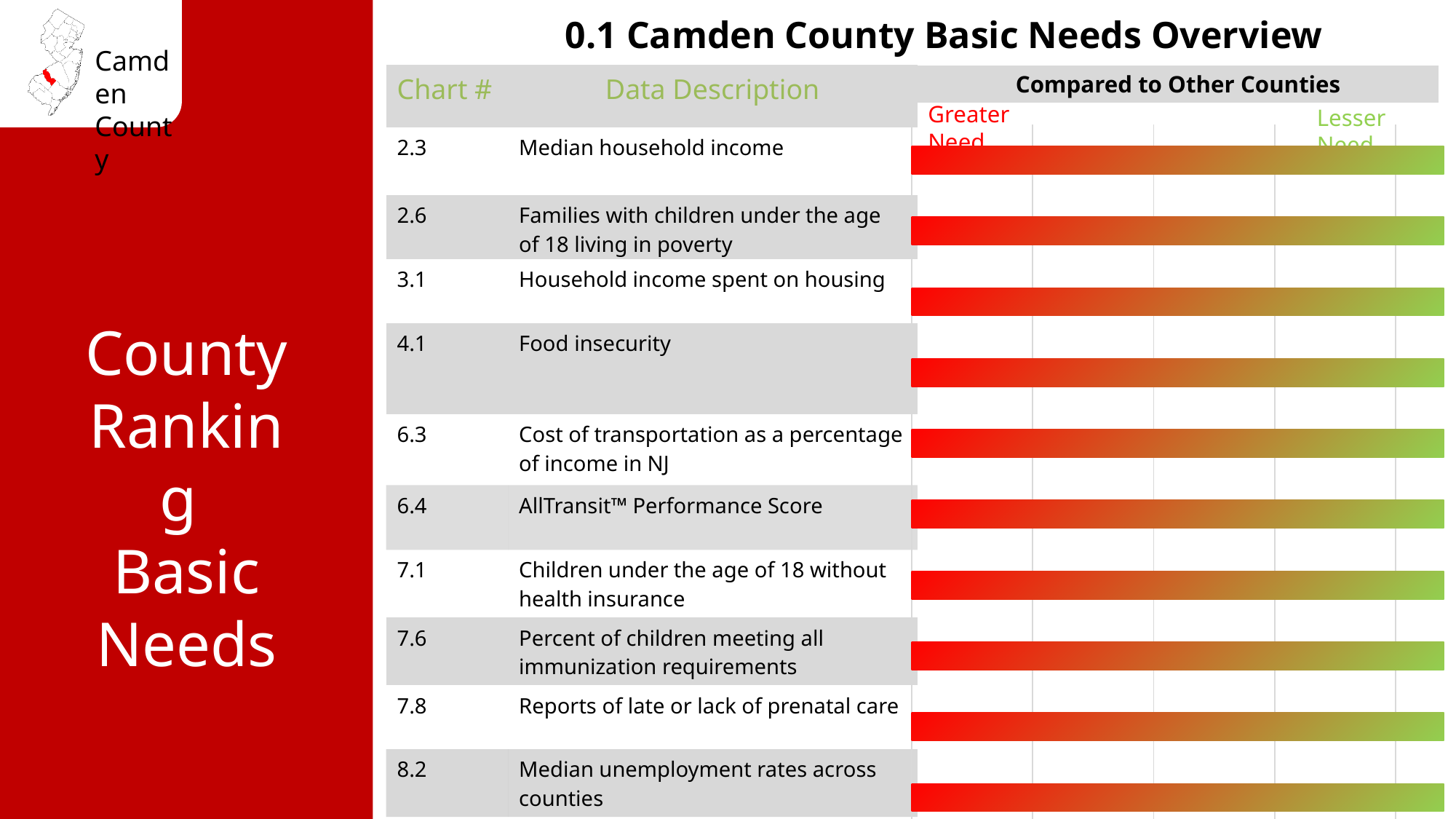
What is the title of the chart on the slide? 0.1 Camden County Basic Needs Overview What kind of chart is shown on the slide? bar chart What chart number is listed for "AllTransit™ Performance Score"? 6.4 What chart number is listed for "Median unemployment rates across counties"? 8.2 What label appears at the left end of the bar scale? Greater Need Which data description is listed for chart number 7.8? Reports of late or lack of prenatal care Which data description is listed for chart number 2.3? Median household income How many data description rows (bars) are shown in the chart? 10 What chart number is listed for "Food insecurity"? 4.1